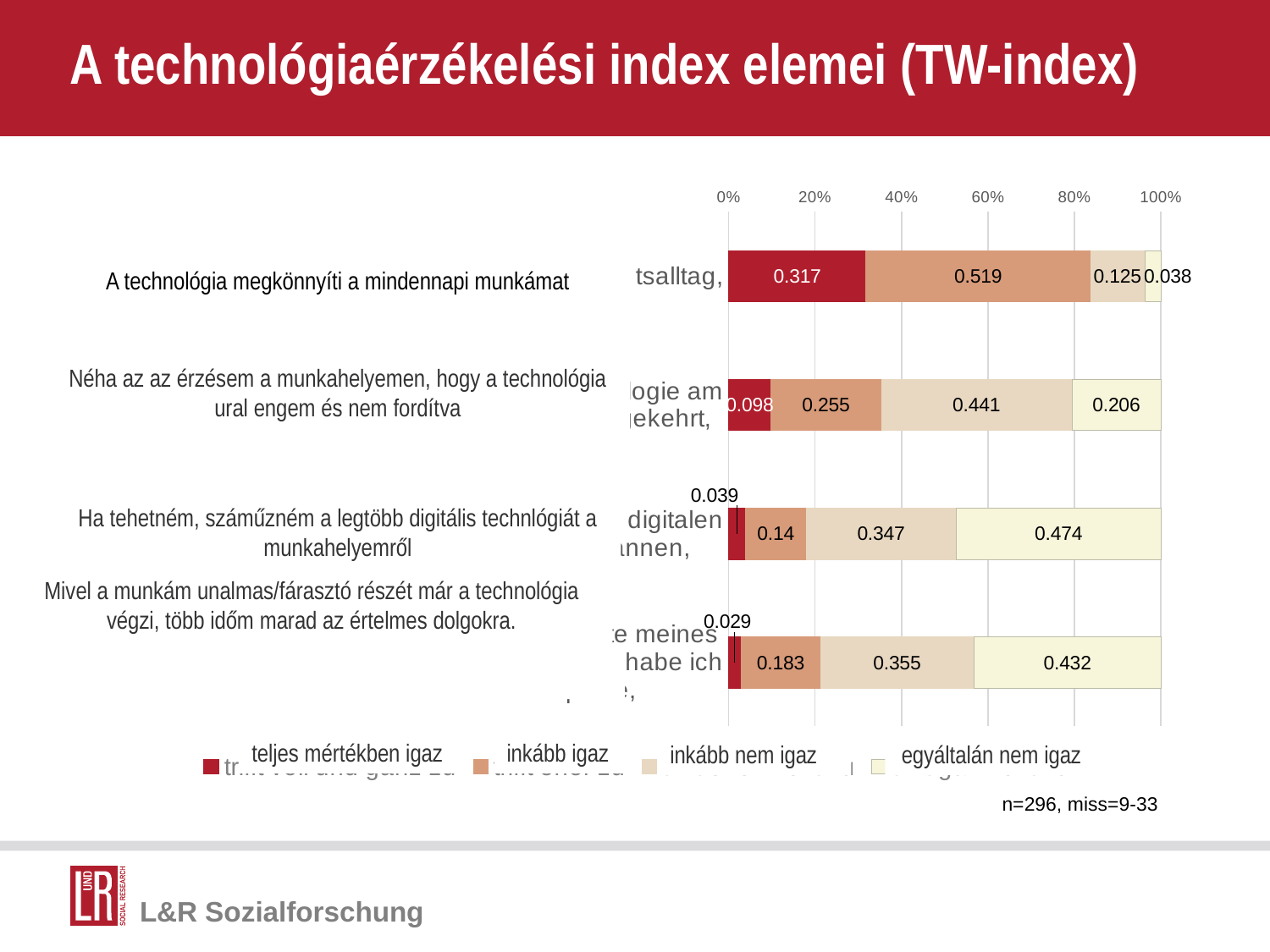
What is the 'teljes mértékben igaz' value for 'Mivel a munkám unalmas/fárasztó részét már a technológia végzi, több időm marad az értelmes dolgokra.'? 0.029 Which is larger: the 'inkább igaz' value for 'Néha az az érzésem a munkahelyemen, hogy a technológia ural engem és nem fordítva' or for 'Mivel a munkám unalmas/fárasztó részét már a technológia végzi, több időm marad az értelmes dolgokra.'? Néha az az érzésem a munkahelyemen, hogy a technológia ural engem és nem fordítva What is the 'inkább igaz' value for 'A technológia megkönnyíti a mindennapi munkámat'? 0.519 How many series does the legend list? 4 Which statement has the lowest 'teljes mértékben igaz' value? Mivel a munkám unalmas/fárasztó részét már a technológia végzi, több időm marad az értelmes dolgokra. What is the difference between the 'egyáltalán nem igaz' values for 'Ha tehetném, száműzném a legtöbb digitális technlógiát a munkahelyemről' and 'Mivel a munkám unalmas/fárasztó részét már a technológia végzi, több időm marad az értelmes dolgokra.'? 0.042 What is the 'teljes mértékben igaz' value for 'A technológia megkönnyíti a mindennapi munkámat'? 0.317 How many statements (categories) are plotted in the chart? 4 What is the 'inkább nem igaz' value for 'Néha az az érzésem a munkahelyemen, hogy a technológia ural engem és nem fordítva'? 0.441 What is the 'egyáltalán nem igaz' value for 'Ha tehetném, száműzném a legtöbb digitális technlógiát a munkahelyemről'? 0.474 Which statement has the highest 'teljes mértékben igaz' value? A technológia megkönnyíti a mindennapi munkámat What kind of chart is shown on the slide? stacked bar chart